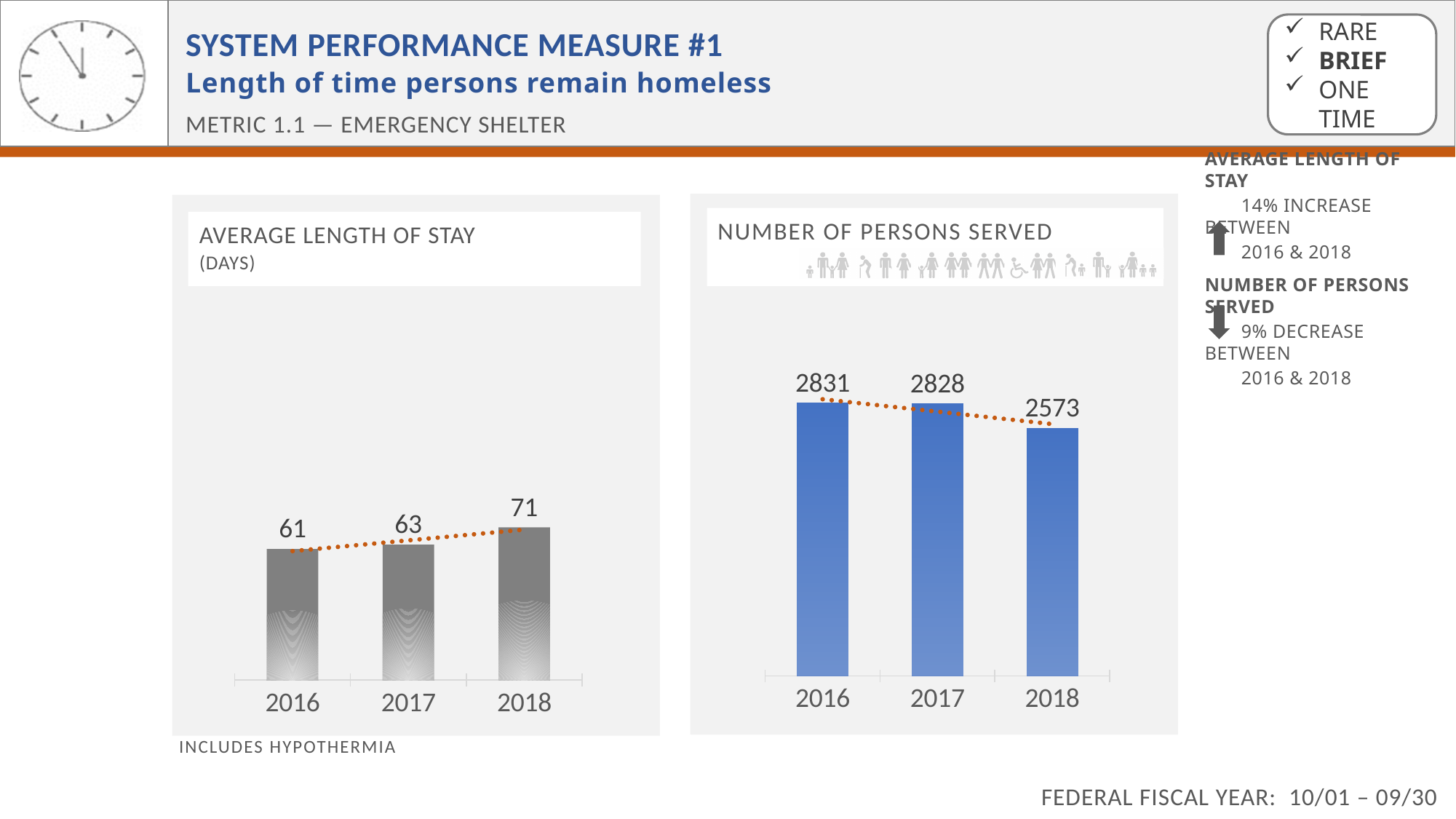
In the Average Length of Stay chart, what is the value for 2016? 61 In the Average Length of Stay chart, which year has the highest value? 2018 How many years are shown in the Average Length of Stay chart? 3 In the Average Length of Stay chart, do the values rise or fall from 2016 to 2018? rise What kind of chart is the Number of Persons Served chart? bar chart In the Number of Persons Served chart, what is the value for 2017? 2828 In the Number of Persons Served chart, what is the difference between the 2016 and 2018 values? 258 In the Average Length of Stay chart, what is the value for 2018? 71 In the Number of Persons Served chart, what is the value for 2018? 2573 In the Number of Persons Served chart, which year has the lowest value? 2018 In the Number of Persons Served chart, which is larger, the value for 2016 or the value for 2018? 2016 In the Average Length of Stay chart, what is the difference between the 2018 and 2016 values? 10